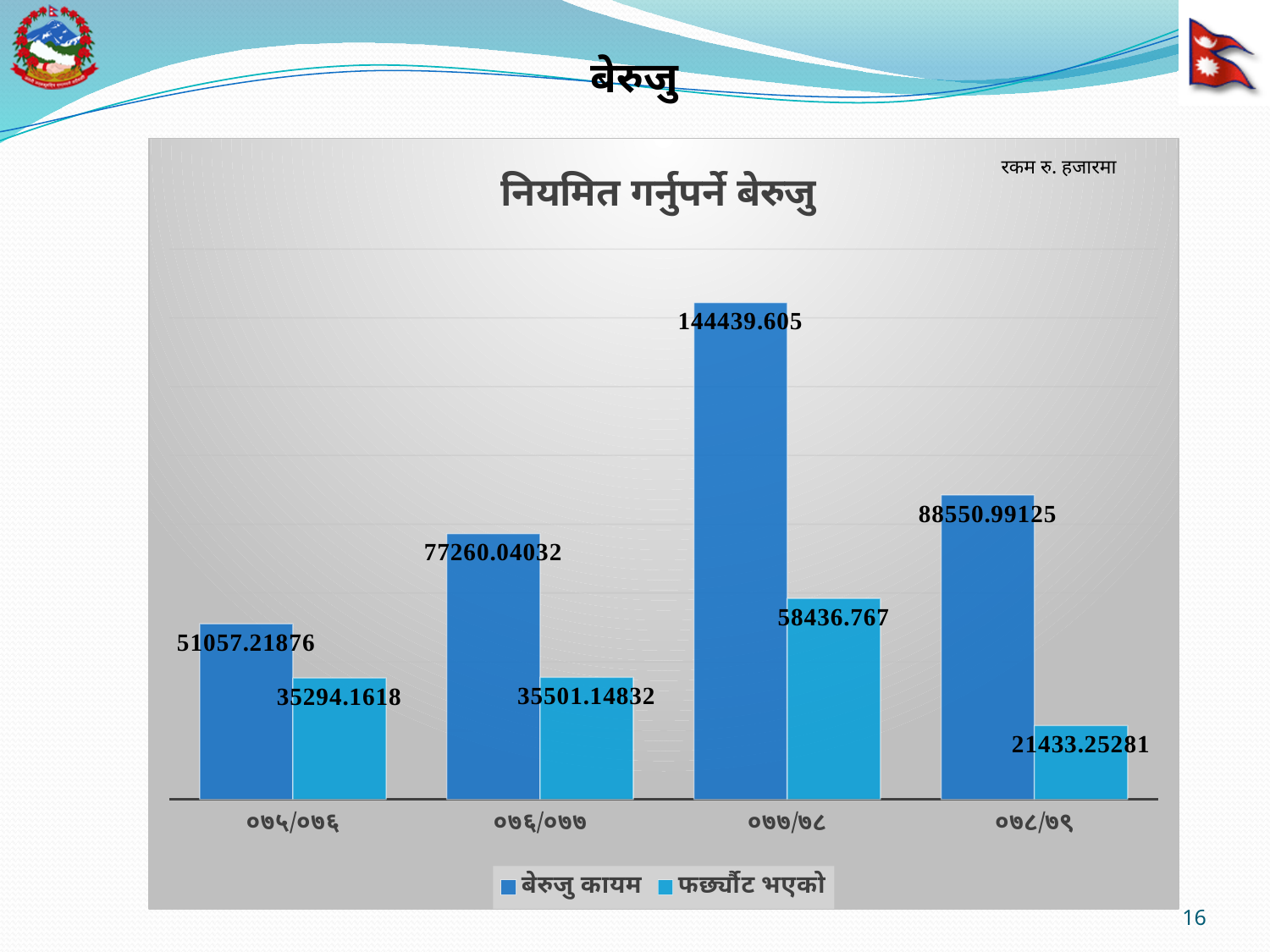
What is the value of बेरुजु कायम for ०७५/०७६? 51057.21876 What is the title of the chart? नियमित गर्नुपर्ने बेरुजु Which is larger: बेरुजु कायम for ०७६/०७७ or बेरुजु कायम for ०७८/७९? बेरुजु कायम for ०७८/७९ How many categories are shown on the x axis? 4 How many series does the legend list? 2 What is the value of फर्छ्यौट भएको for ०७८/७९? 21433.25281 What is the value of फर्छ्यौट भएको for ०७६/०७७? 35501.14832 Which category has the highest value for बेरुजु कायम? ०७७/७८ What is the difference between बेरुजु कायम and फर्छ्यौट भएको for ०७७/७८? 86002.838 What is the value of बेरुजु कायम for ०७७/७८? 144439.605 What type of chart is shown on the slide? bar chart Which category has the lowest value for फर्छ्यौट भएको? ०७८/७९